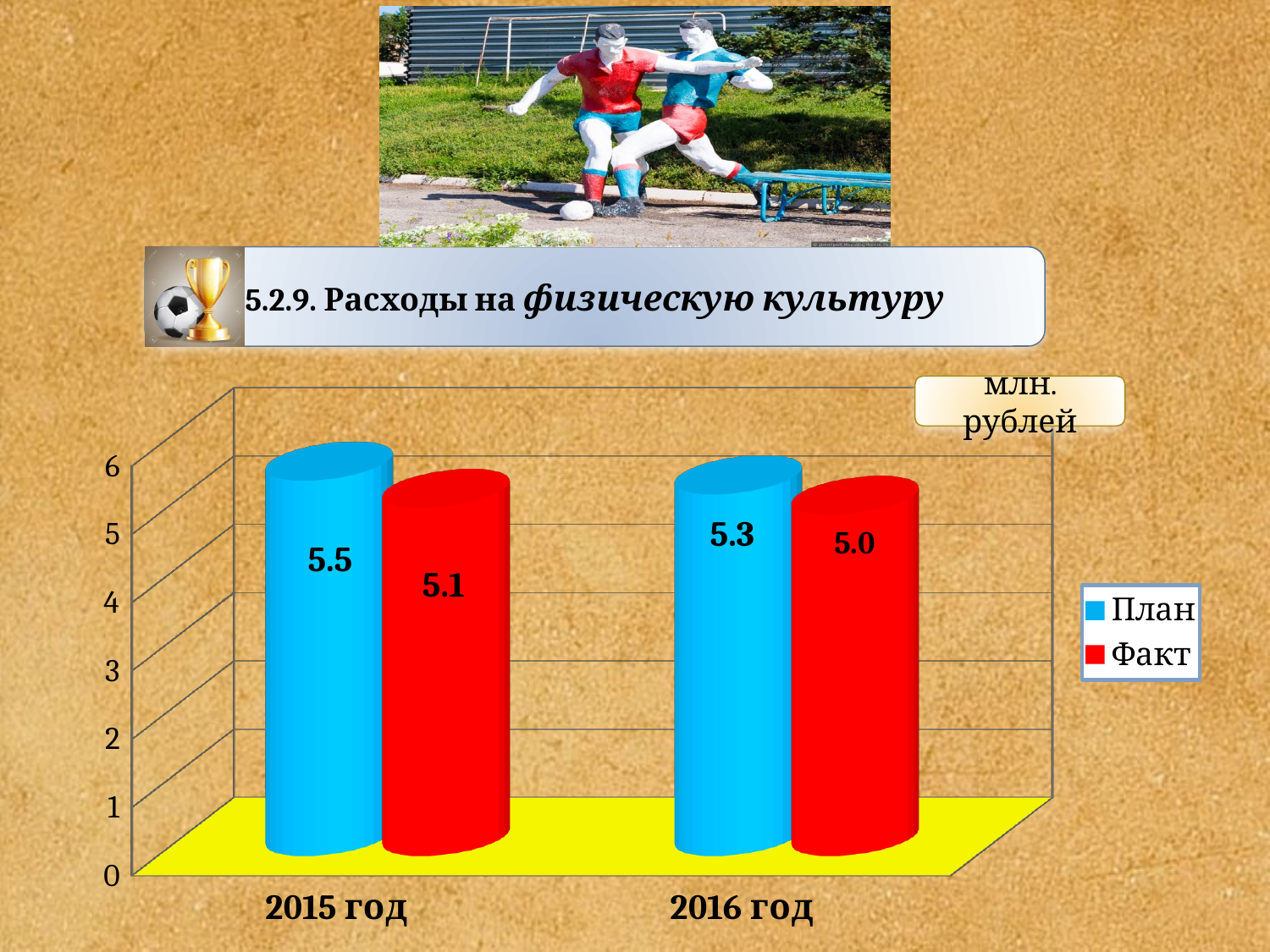
Which year has the lower Факт value? 2016 год What is the difference between План and Факт for 2015 год? 0.4 What is the План value for 2016 год? 5.3 Which year has the higher План value? 2015 год What is the План value for 2015 год? 5.5 How many series does the legend list? 2 What is the difference between План and Факт for 2016 год? 0.3 Which is larger for 2016 год, План or Факт? План What unit is shown in the box above the chart? млн. рублей What kind of chart is shown on the slide? bar chart What is the Факт value for 2015 год? 5.1 What is the Факт value for 2016 год? 5.0